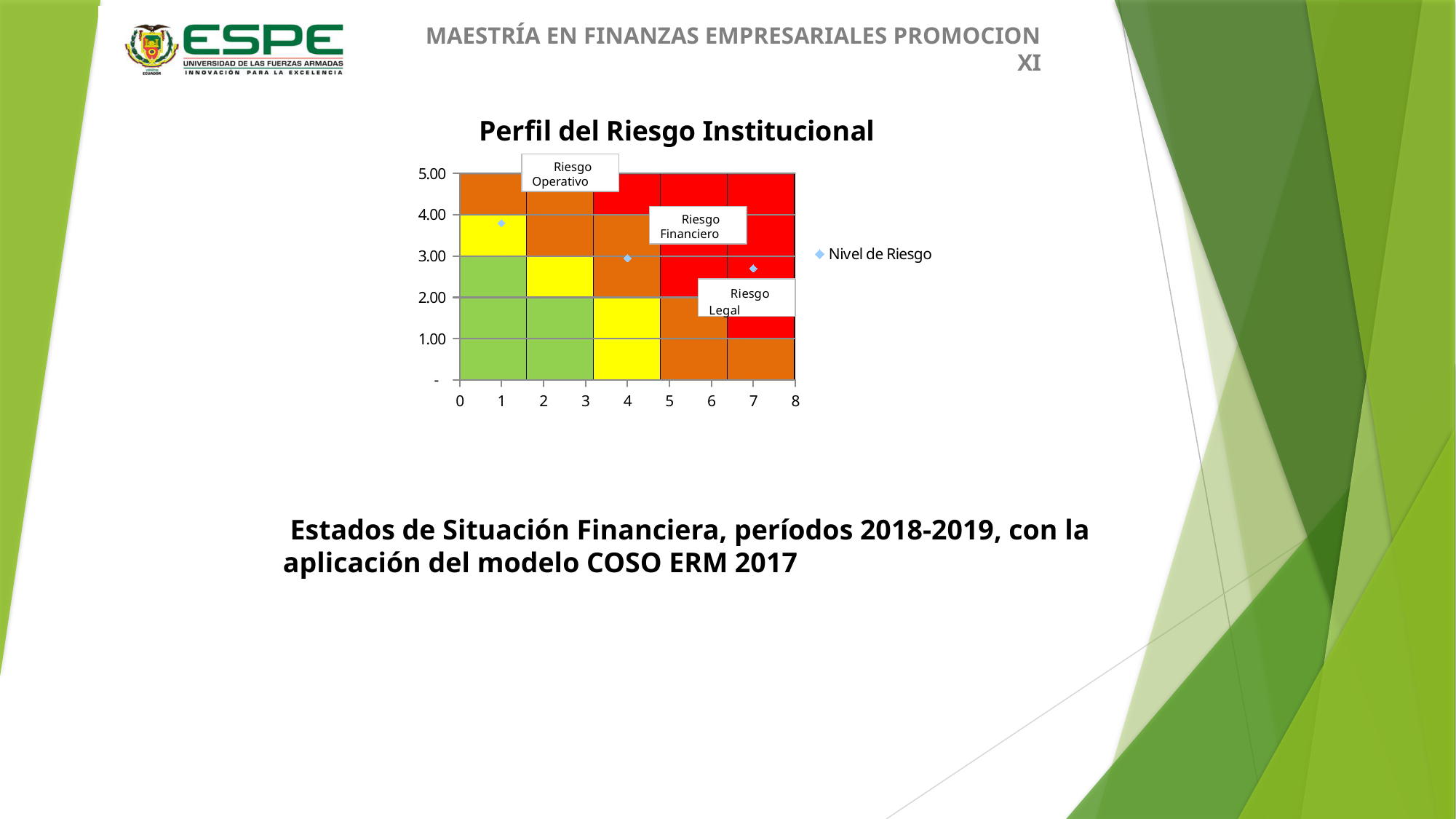
How many series does the legend list? 1 Which risk is plotted furthest to the right on the horizontal axis? Riesgo Legal Is the vertical-axis value for Riesgo Legal greater or less than 3.00? less What is the name of the series shown in the legend? Nivel de Riesgo What is the title of the chart? Perfil del Riesgo Institucional How many data points are plotted in the chart? 3 Which has a higher vertical-axis value, Riesgo Operativo or Riesgo Legal? Riesgo Operativo Which risk has the highest value on the vertical axis? Riesgo Operativo What kind of chart is shown on the slide? scatter chart Which risk is plotted furthest to the left on the horizontal axis? Riesgo Operativo Is the vertical-axis value for Riesgo Operativo greater or less than 3.00? greater Do the vertical-axis values of the points rise or fall as you move from left to right along the horizontal axis? fall